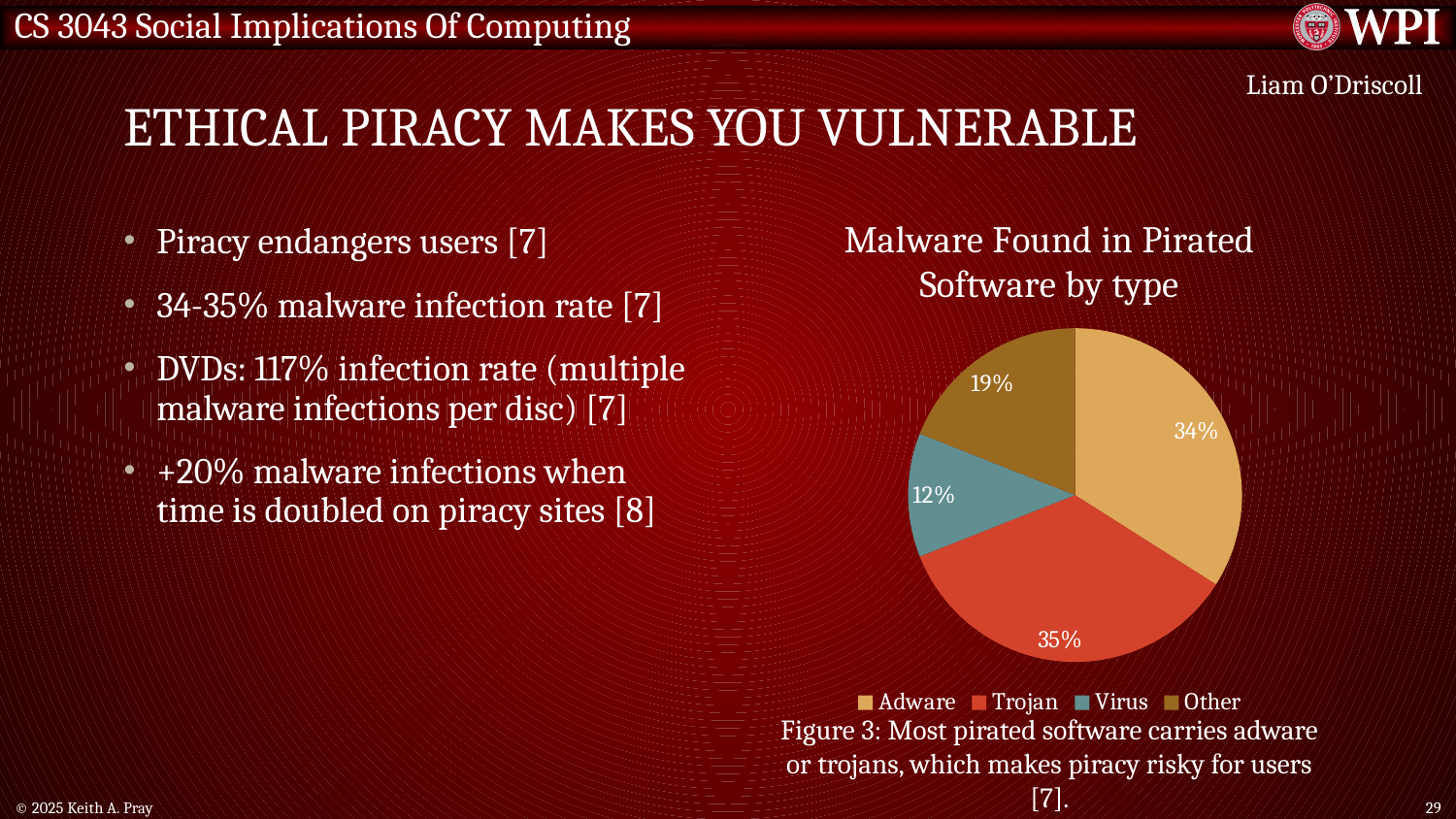
What type of chart is shown on the slide? pie chart What share of malware found in pirated software is Virus? 12% What share of malware found in pirated software is Other? 19% What is the difference in percentage points between the Other slice and the Virus slice? 7 What share of malware found in pirated software is Adware? 34% Which is larger, the Virus slice or the Other slice? Other How many malware types does the legend list? 4 What share of malware found in pirated software is Trojan? 35% What colour is the Trojan slice in the pie chart? red Which malware type has the smallest slice of the pie? Virus What is the title of the pie chart? Malware Found in Pirated Software by type Which malware type has the largest slice of the pie? Trojan